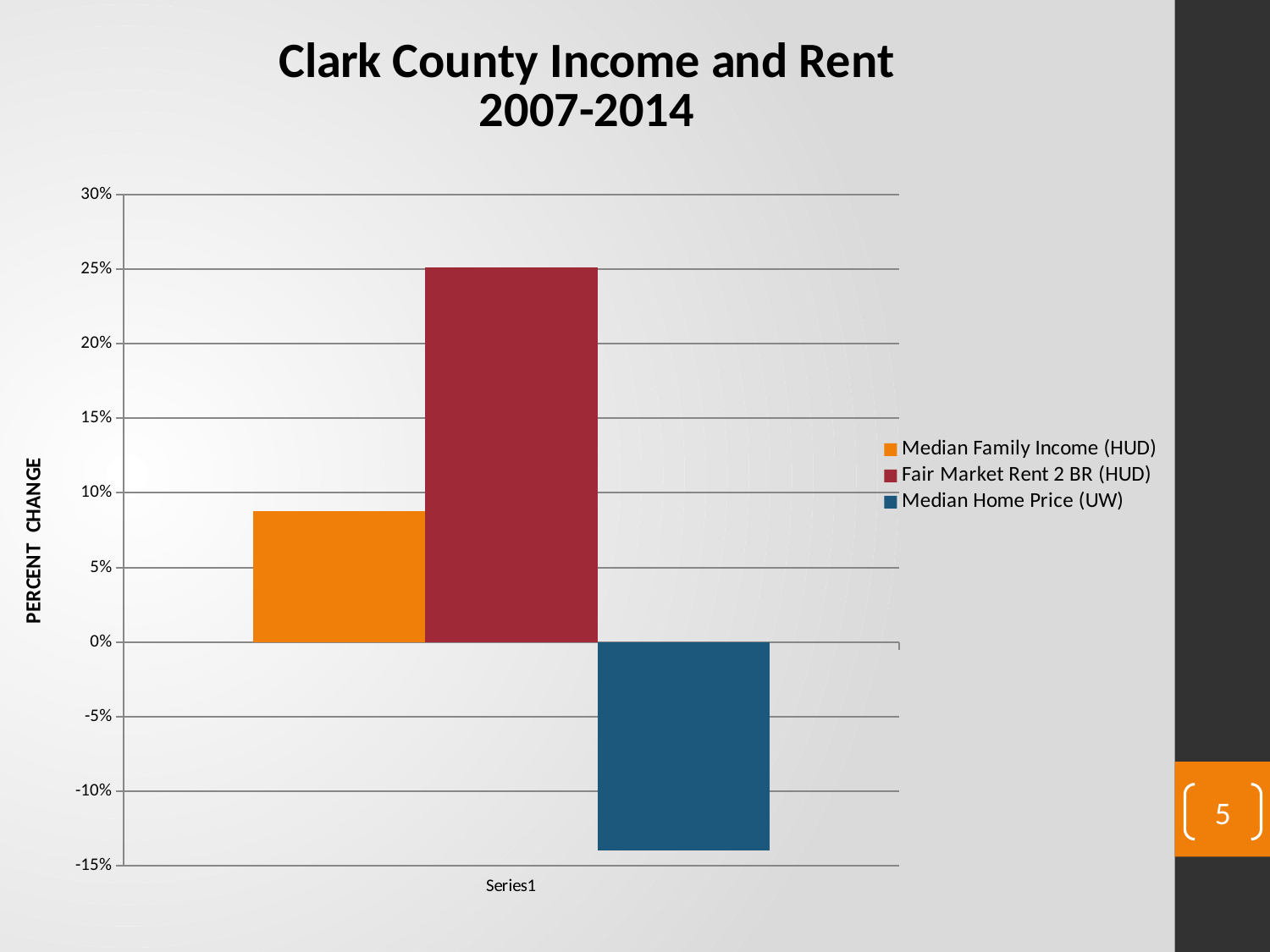
What is the label on the vertical axis? PERCENT CHANGE Which series is the only one with a negative value? Median Home Price (UW) Which is larger, the value for Median Family Income (HUD) or the value for Fair Market Rent 2 BR (HUD)? Fair Market Rent 2 BR (HUD) Is the value for Median Home Price (UW) greater or less than -10%? less Which series has the highest value? Fair Market Rent 2 BR (HUD) Is the value for Fair Market Rent 2 BR (HUD) greater or less than 20%? greater What type of chart is shown on the slide? bar chart Is the value for Median Family Income (HUD) greater or less than 10%? less How many series does the legend list? 3 Which series has the lowest value? Median Home Price (UW) What is the title of the chart? Clark County Income and Rent 2007-2014